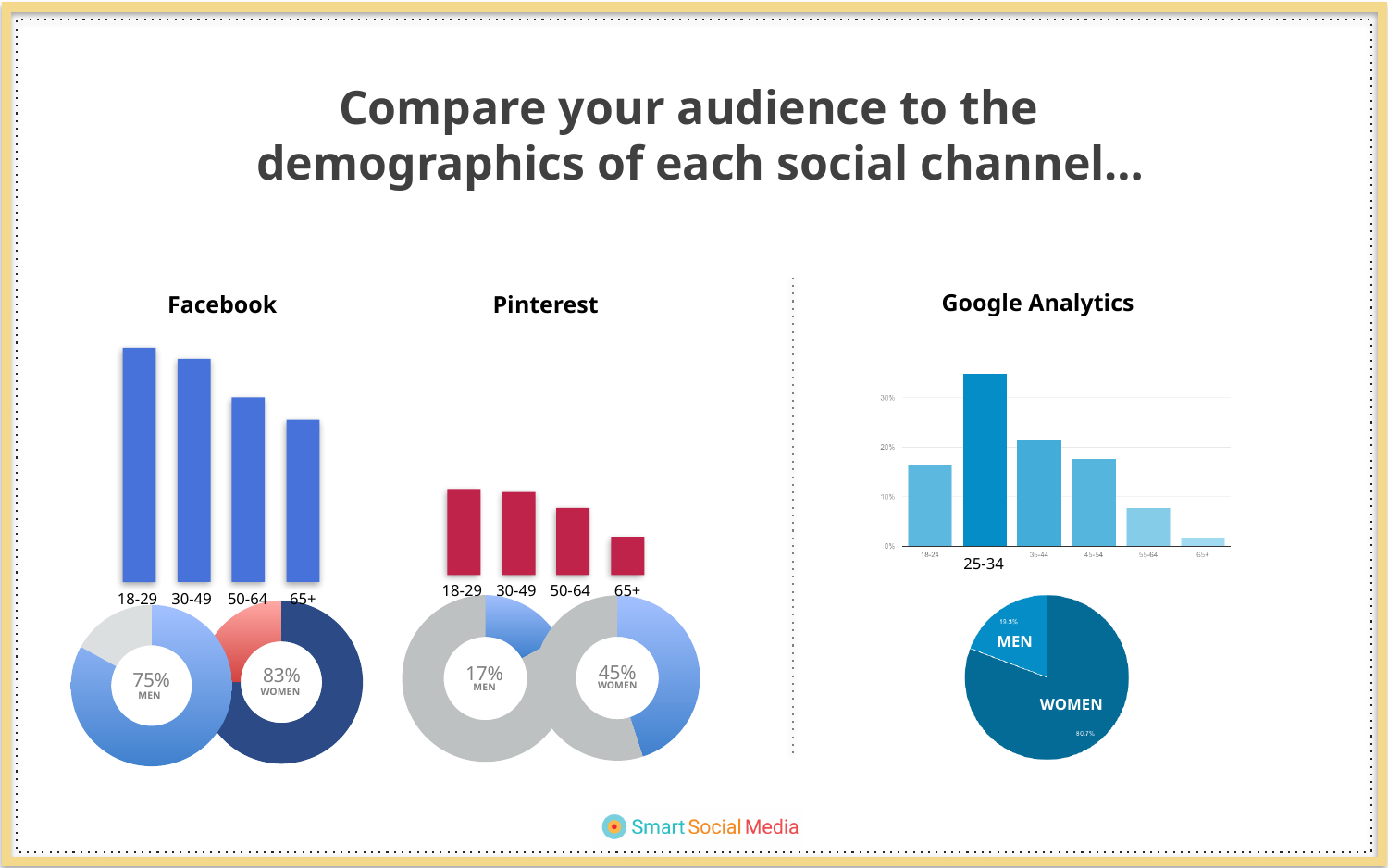
In the Google Analytics pie chart, which slice is larger, MEN or WOMEN? WOMEN In the Facebook bar chart, do the values rise or fall from 18-29 to 65+? fall In the Pinterest bar chart, which age group has the lowest bar? 65+ What type of chart is the Facebook chart showing age groups? bar chart In the Google Analytics bar chart, which age group has the highest value? 25-34 In the Google Analytics bar chart, is the value for 25-34 greater or less than 30%? greater In the Pinterest donut charts, what percentage is shown for women? 45% In the Facebook bar chart, which age group has the highest bar? 18-29 How many age groups are shown in the Facebook bar chart? 4 In the Pinterest donut charts, what percentage is shown for men? 17% In the Facebook donut charts, what percentage is shown for men? 75% In the Facebook donut charts, what percentage is shown for women? 83%